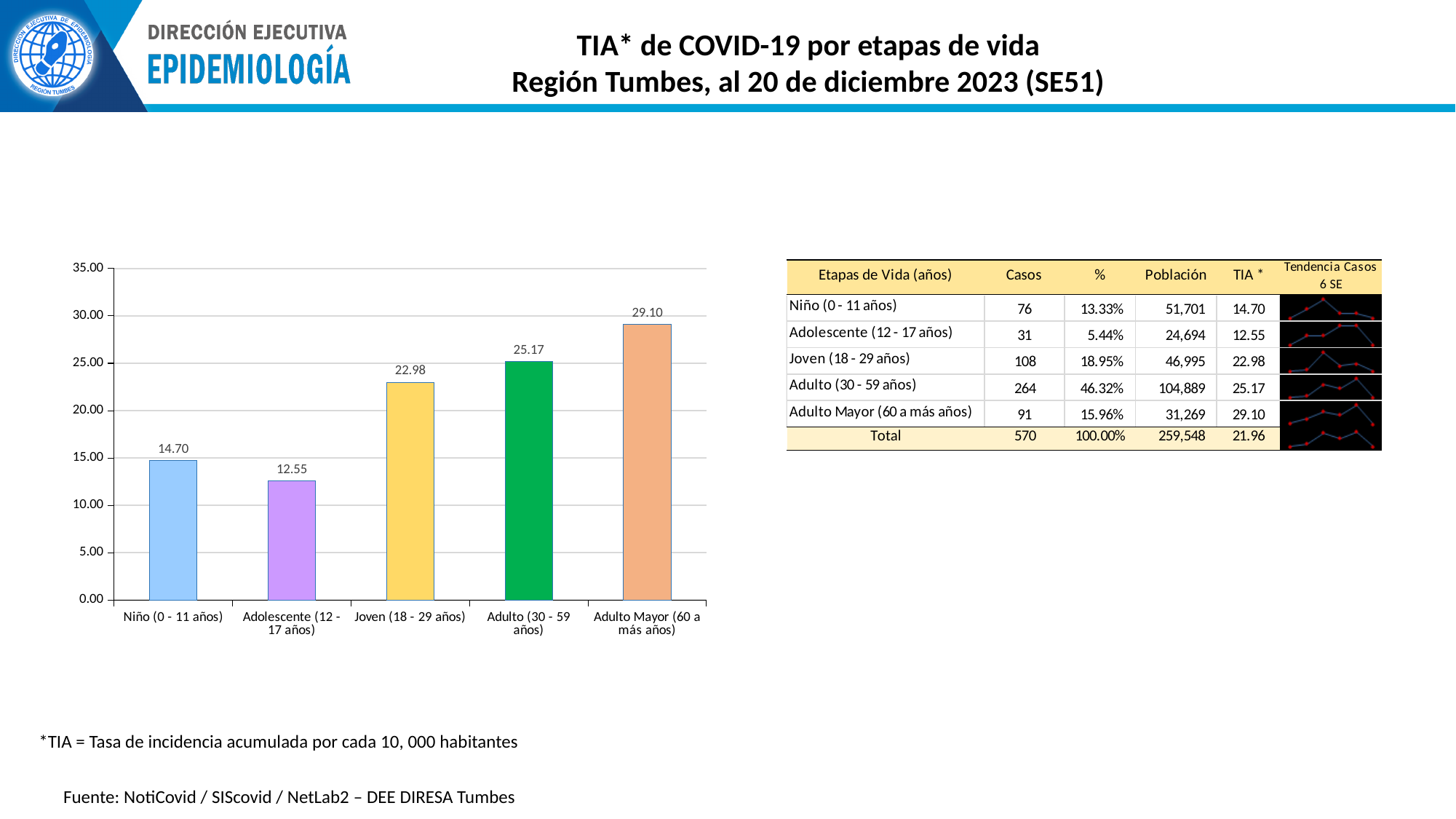
What is the difference between the TIA for Adulto Mayor (60 a más años) and Niño (0 - 11 años)? 14.40 What is the TIA value for Adulto (30 - 59 años) in the bar chart? 25.17 How many age groups are shown in the bar chart? 5 Which has a higher TIA, Joven (18 - 29 años) or Adulto (30 - 59 años)? Adulto (30 - 59 años) Which age group has the highest TIA in the bar chart? Adulto Mayor (60 a más años) Which age group has the lowest TIA in the bar chart? Adolescente (12 - 17 años) What is the maximum value shown on the vertical axis of the bar chart? 35.00 What is the TIA value for Joven (18 - 29 años) in the bar chart? 22.98 Is the TIA value for Adolescente (12 - 17 años) greater or less than 15.00? less What colour is the bar for Adulto (30 - 59 años)? green What type of chart is used to show TIA by age group? bar chart What is the TIA value for Niño (0 - 11 años) in the bar chart? 14.70